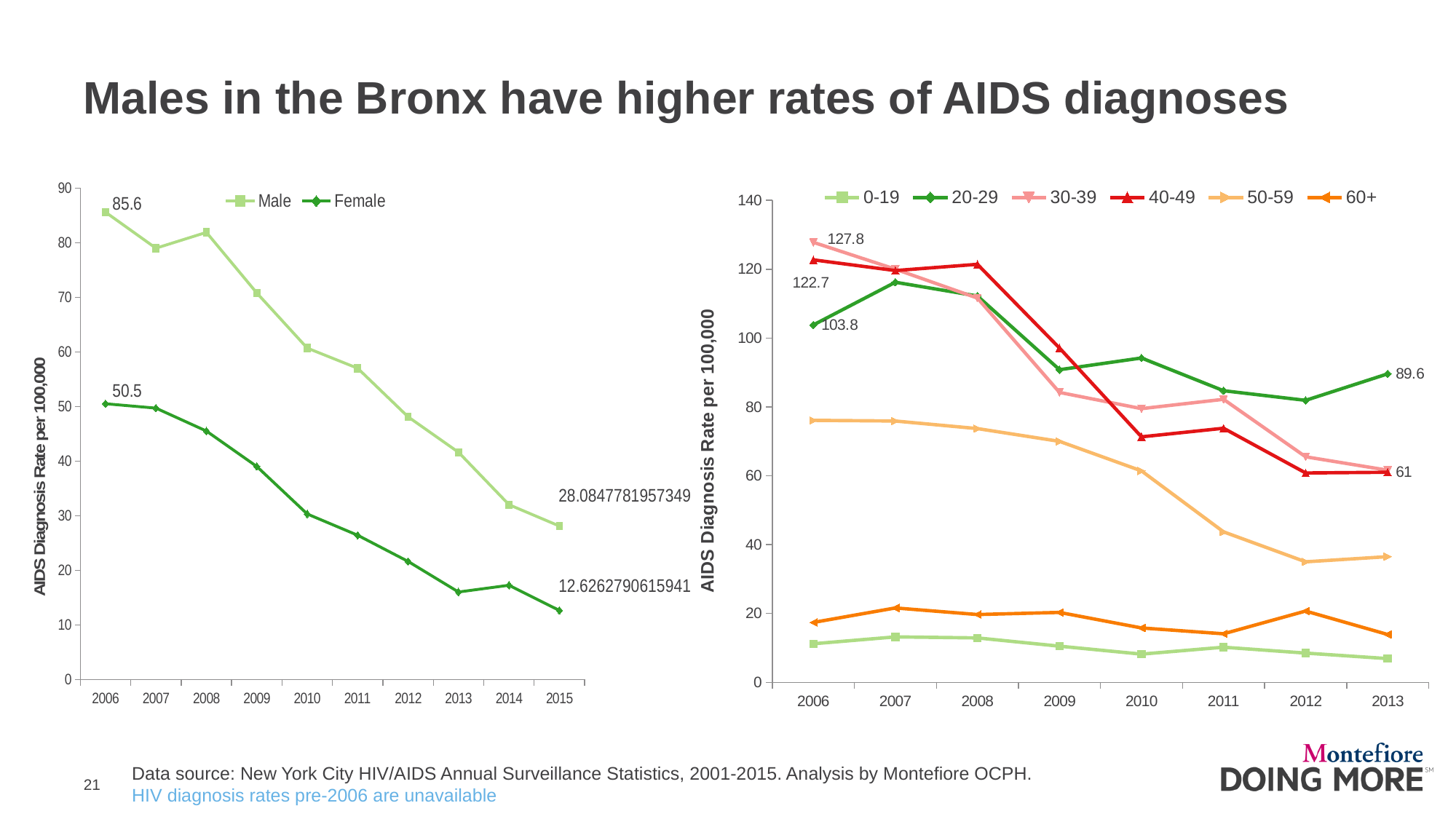
What kind of chart is the chart on the left of the slide? line chart How many series does the legend of the chart on the left list? 2 In the chart on the right, is the value for the 50-59 age group in 2006 greater or less than 80? less In the chart on the left, what is the AIDS diagnosis rate for Male in 2006? 85.6 In the chart on the right, which age group has the highest rate in 2006? 30-39 How many years are shown on the x axis of the chart on the left? 10 In the chart on the right, what is the AIDS diagnosis rate for the 30-39 age group in 2006? 127.8 In the chart on the left, does the Male rate rise or fall from 2006 to 2015? fall In the chart on the right, what is the AIDS diagnosis rate for the 20-29 age group in 2013? 89.6 In the chart on the left, what is the difference between the Male and Female rates in 2006? 35.1 In the chart on the left, what is the AIDS diagnosis rate for Female in 2006? 50.5 How many series does the legend of the chart on the right list? 6